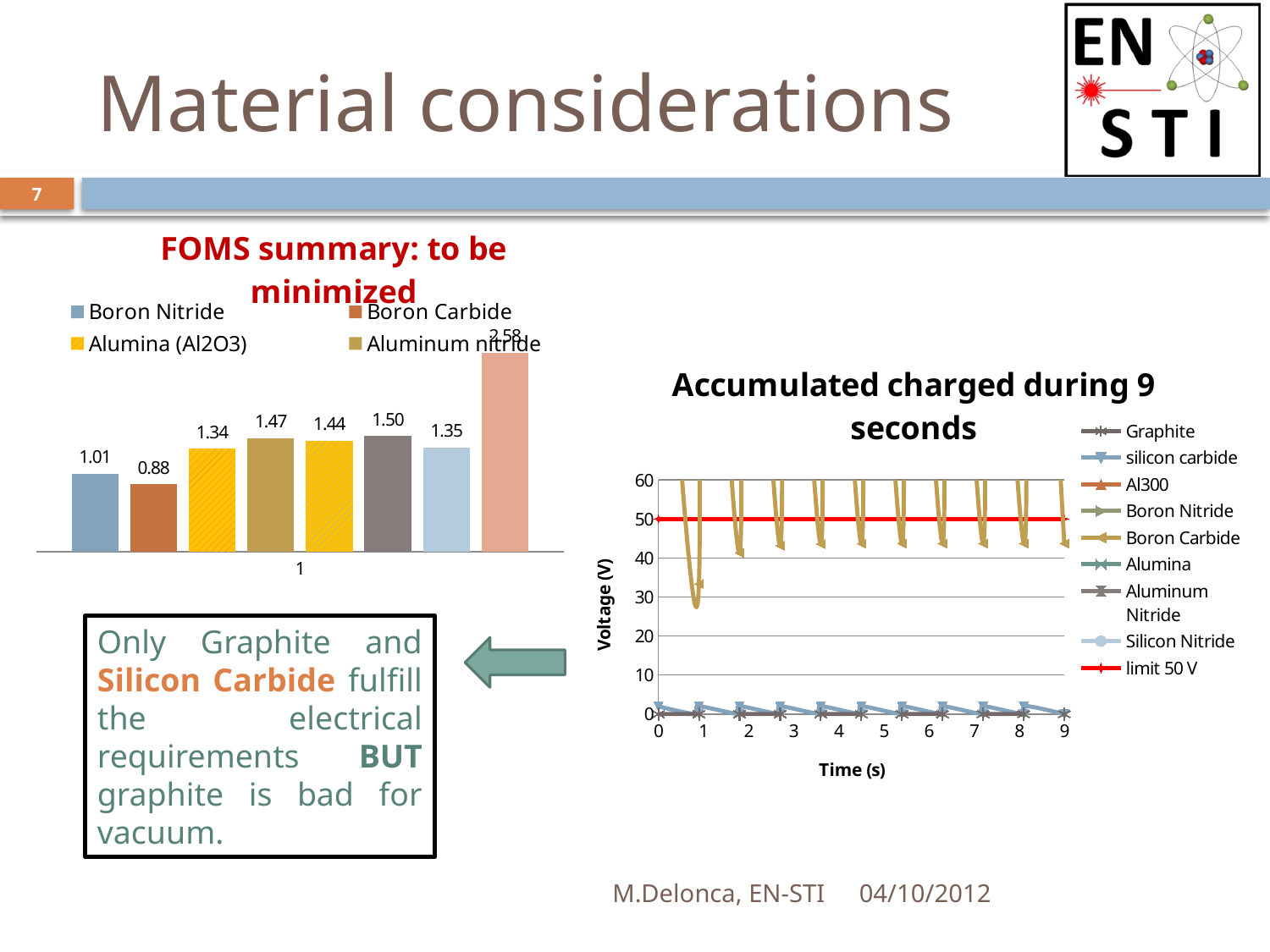
In the 'Accumulated charged during 9 seconds' chart, what is the label of the vertical axis? Voltage (V) In the 'FOMS summary: to be minimized' chart, what is the difference between the values for Boron Nitride and Boron Carbide? 0.13 In the 'FOMS summary: to be minimized' chart, what is the highest value labelled on any bar? 2.58 What kind of chart is the 'FOMS summary: to be minimized' chart? bar chart In the 'FOMS summary: to be minimized' chart, what is the value for Boron Nitride? 1.01 In the 'FOMS summary: to be minimized' chart, how many bars are plotted? 8 In the 'Accumulated charged during 9 seconds' chart, how many series does the legend list? 9 In the 'FOMS summary: to be minimized' chart, which is larger, the value for Aluminum nitride or the value for Boron Nitride? Aluminum nitride In the 'FOMS summary: to be minimized' chart, what is the value for Aluminum nitride? 1.47 In the 'FOMS summary: to be minimized' chart, which material has the lowest value? Boron Carbide In the 'Accumulated charged during 9 seconds' chart, is the voltage for Graphite greater or less than 10? less In the 'FOMS summary: to be minimized' chart, what is the value for Boron Carbide? 0.88